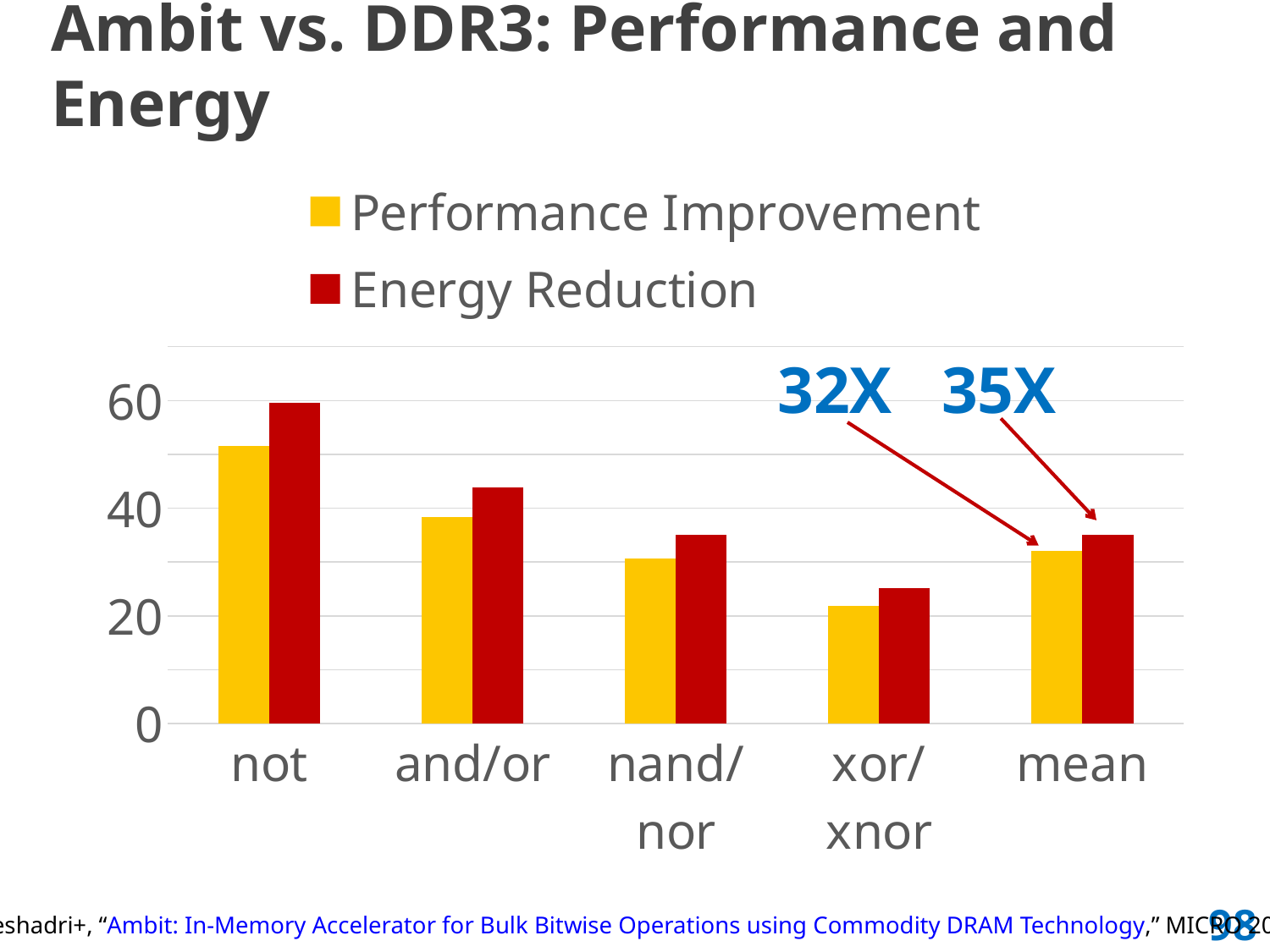
For the not category, which is larger: Performance Improvement or Energy Reduction? Energy Reduction How many series does the legend list? 2 Is the Performance Improvement value for not greater or less than 40? greater Which category has the highest Energy Reduction? not What kind of chart is shown on the slide? bar chart What is the Energy Reduction value for mean? 35X Which category has the lowest Performance Improvement? xor/xnor How many categories are shown on the x axis? 5 Is the Energy Reduction value for xor/xnor greater or less than 40? less What is the difference between the Energy Reduction and Performance Improvement values for mean? 3X Which colour represents Energy Reduction in the legend? red What is the Performance Improvement value for mean? 32X